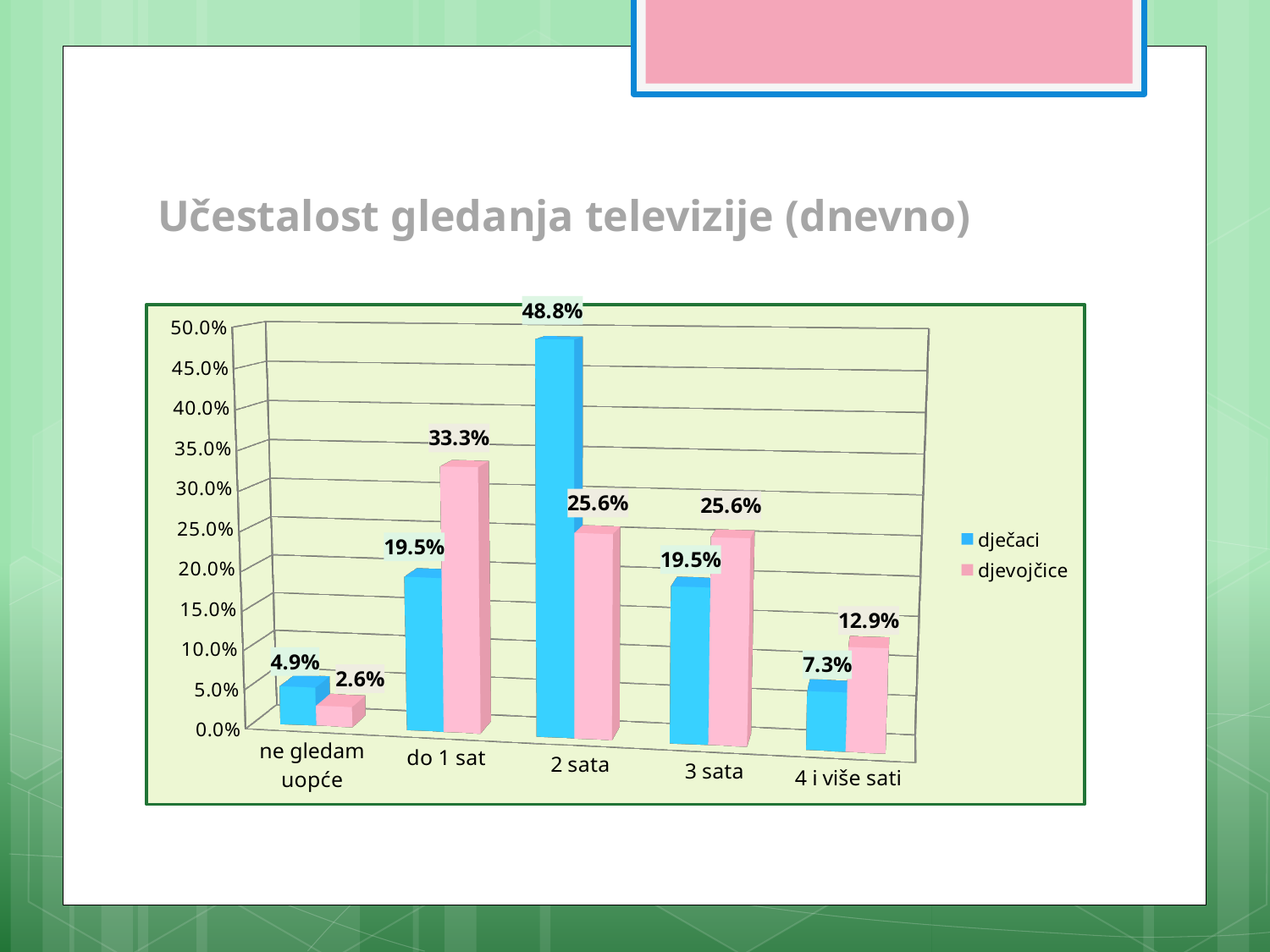
Is the value for dječaci in the 'do 1 sat' category greater or less than 25.0%? less What is the title of the slide above the chart? Učestalost gledanja televizije (dnevno) Which category has the highest value for dječaci? 2 sata How many categories are shown on the x axis? 5 What is the value for djevojčice in the '4 i više sati' category? 12.9% What kind of chart is shown on the slide? bar chart What is the difference between dječaci and djevojčice in the '2 sata' category? 23.2% What is the value for djevojčice in the 'do 1 sat' category? 33.3% Which category has the lowest value for djevojčice? ne gledam uopće What is the value for dječaci in the '2 sata' category? 48.8% Which is larger in the '3 sata' category, dječaci or djevojčice? djevojčice How many series does the legend list? 2